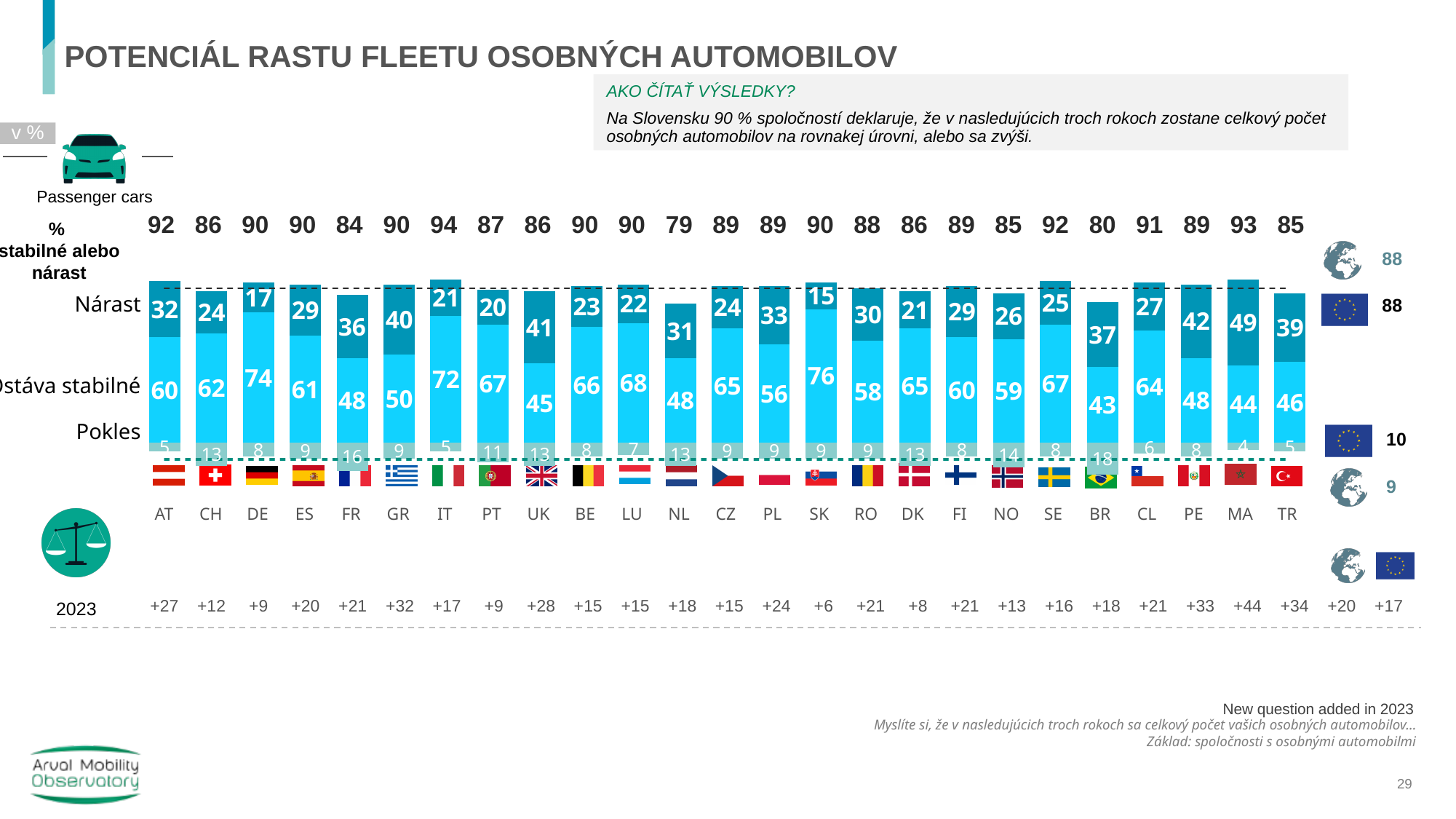
What is the 'Pokles' value for BR? 18 What is the '% stabilné alebo nárast' value shown above the bar for NL? 79 What kind of chart is shown on the slide? stacked bar chart What is the 'Nárast' value for SK? 15 How many countries are shown on the x axis of the chart? 25 What is the difference between the 'Nárast' values for PE and FR? 6 Which is larger, the 'Ostáva stabilné' value for IT or for LU? IT Which country has the highest 'Nárast' value? MA What is the total of the 'Nárast' and 'Ostáva stabilné' segments for UK? 86 Which country has the lowest 'Ostáva stabilné' value? BR Which country has the lowest 'Pokles' value? MA What is the 'Ostáva stabilné' value for DE? 74